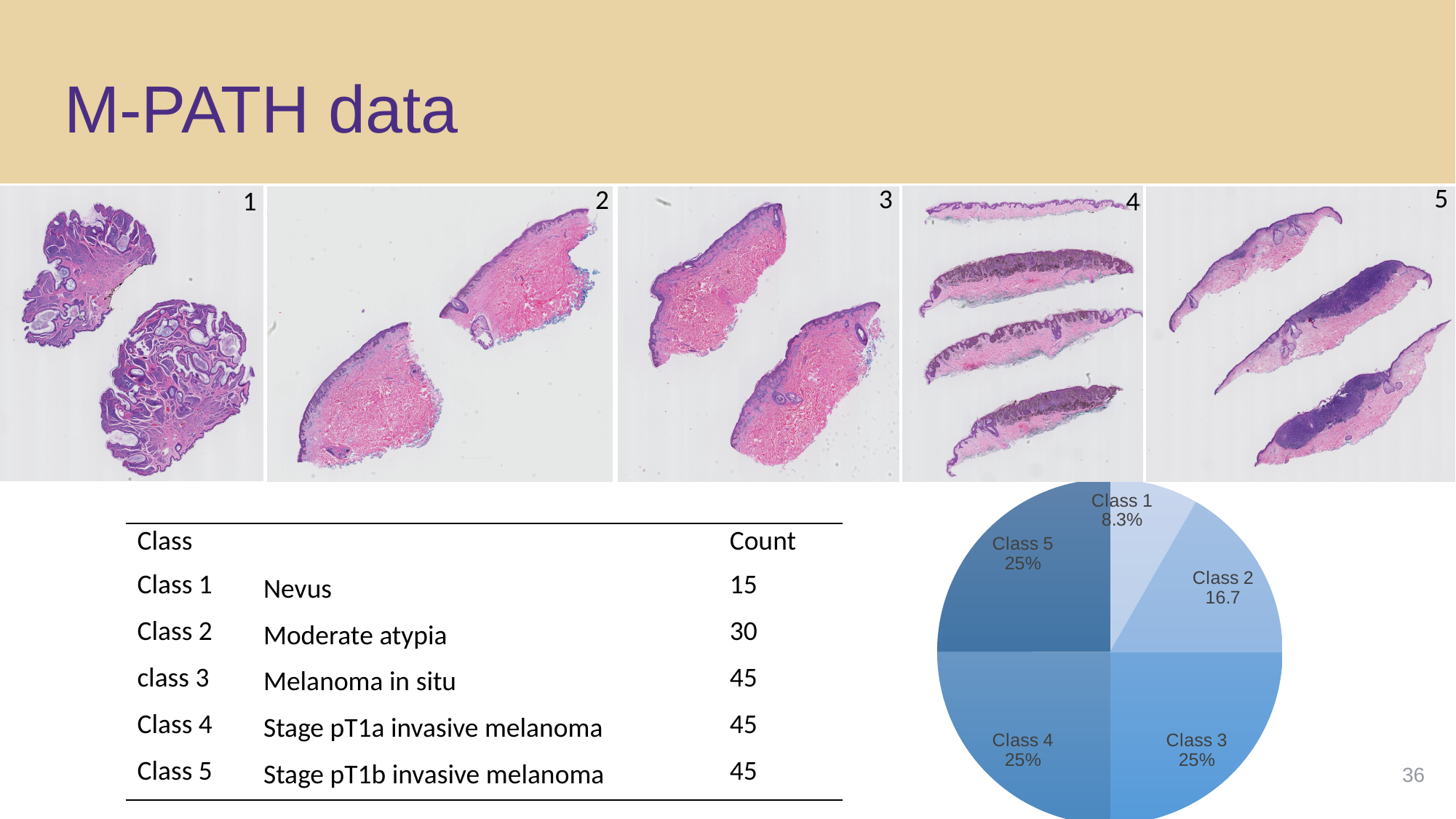
How many classes in the pie chart are labelled with 25%? 3 What share of the pie chart does Class 3 represent? 25% Which class has the smallest slice in the pie chart? Class 1 Which slice is larger in the pie chart, Class 1 or Class 2? Class 2 How many slices does the pie chart have? 5 What value is labelled on the Class 2 slice of the pie chart? 16.7 What colour family is used for the slices of the pie chart? shades of blue Which slice is larger in the pie chart, Class 2 or Class 5? Class 5 What share of the pie chart does Class 5 represent? 25% What kind of chart is shown on the slide? pie chart What share of the pie chart does Class 4 represent? 25%